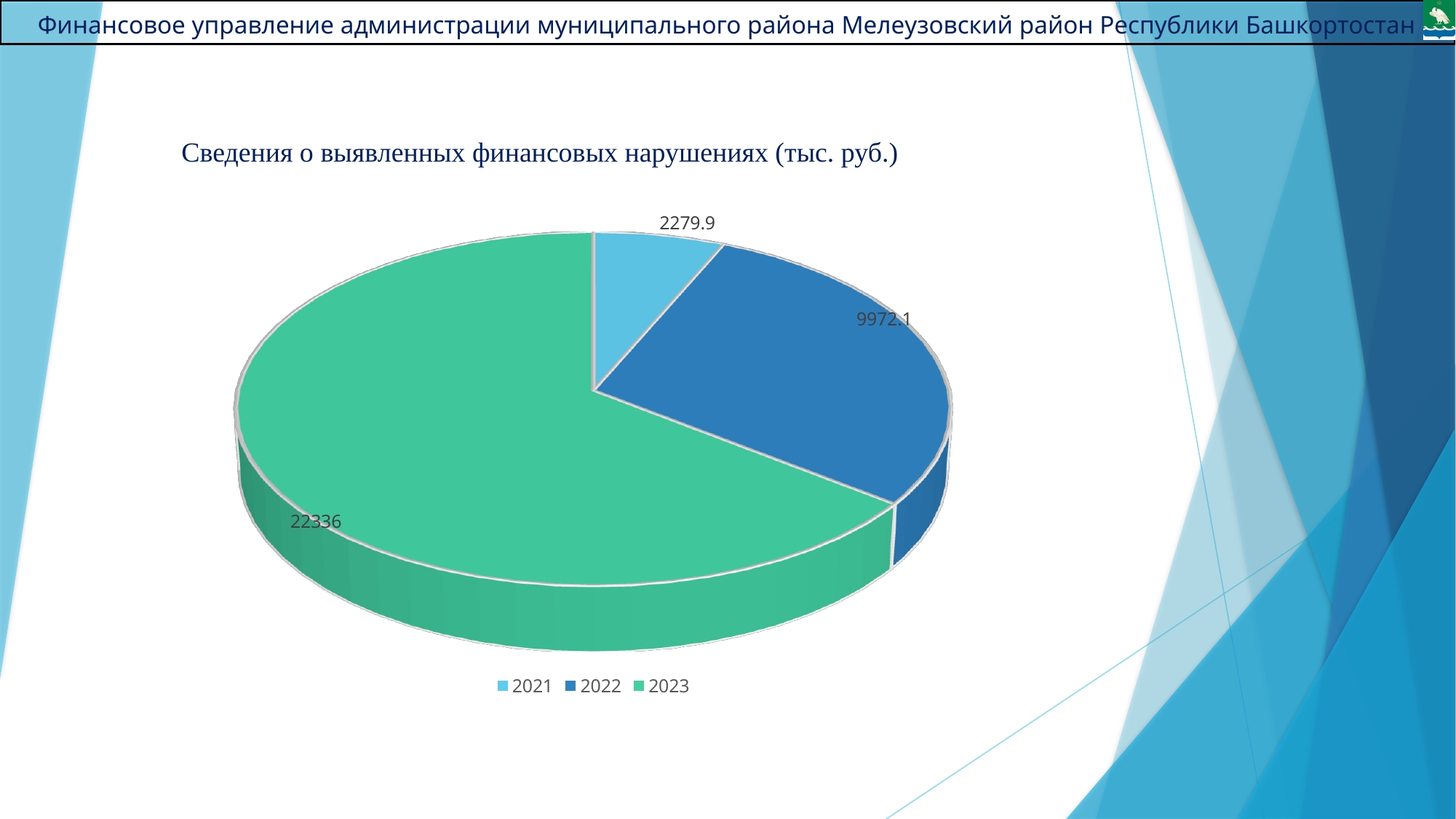
What is the total of all three values in the pie chart? 34588 What is the value shown for 2022 on the pie chart? 9972.1 What is the value shown for 2023 on the pie chart? 22336 What is the difference between the values for 2022 and 2021? 7692.2 Which year has the smallest slice of the pie chart? 2021 What is the value shown for 2021 on the pie chart? 2279.9 How many slices does the pie chart have? 3 Which year has the largest slice of the pie chart? 2023 Which is larger, the value for 2022 or the value for 2021? 2022 What type of chart is shown on the slide? Pie chart What is the title of the chart? Сведения о выявленных финансовых нарушениях (тыс. руб.) What is the difference between the values for 2023 and 2022? 12363.9